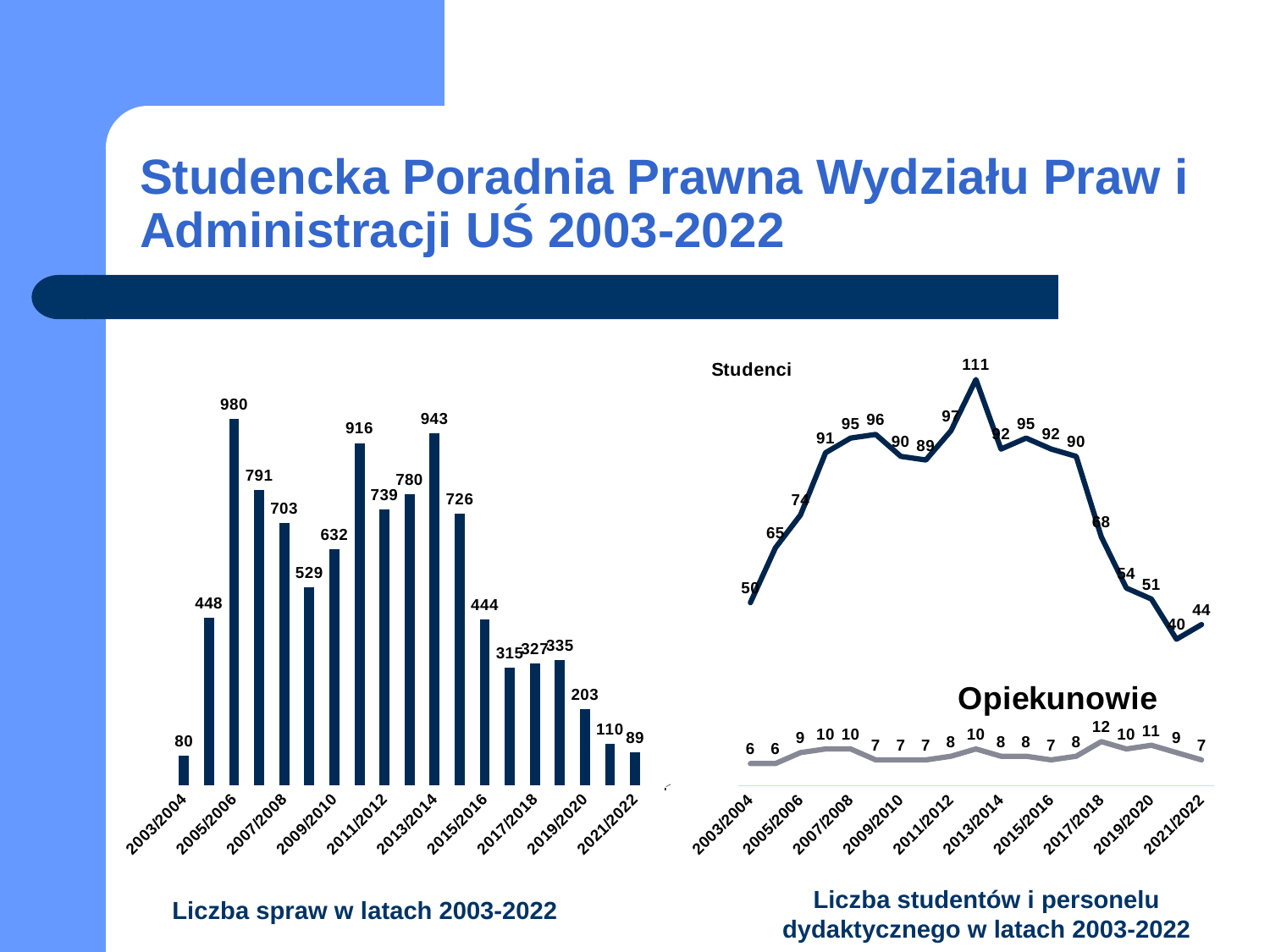
In the chart 'Liczba studentów i personelu dydaktycznego w latach 2003-2022', what is the value of the Studenci series for 2021/2022? 44 In the chart 'Liczba studentów i personelu dydaktycznego w latach 2003-2022', what is the highest value of the Studenci series? 111 In the chart 'Liczba spraw w latach 2003-2022', what is the difference between the values for 2005/2006 and 2013/2014? 37 In the chart 'Liczba spraw w latach 2003-2022', which is larger: the value for 2009/2010 or the value for 2011/2012? 2011/2012 In the chart 'Liczba studentów i personelu dydaktycznego w latach 2003-2022', what is the value of the Opiekunowie series for 2017/2018? 12 How many series are plotted in the chart 'Liczba studentów i personelu dydaktycznego w latach 2003-2022'? 2 In the chart 'Liczba spraw w latach 2003-2022', which year has the lowest value? 2003/2004 What kind of chart is 'Liczba spraw w latach 2003-2022'? bar chart In the chart 'Liczba studentów i personelu dydaktycznego w latach 2003-2022', does the Studenci series rise or fall between 2017/2018 and 2020/2021? fall In the chart 'Liczba spraw w latach 2003-2022', which year has the highest value? 2005/2006 In the chart 'Liczba spraw w latach 2003-2022', what is the value for 2013/2014? 943 In the chart 'Liczba spraw w latach 2003-2022', what is the value for 2005/2006? 980